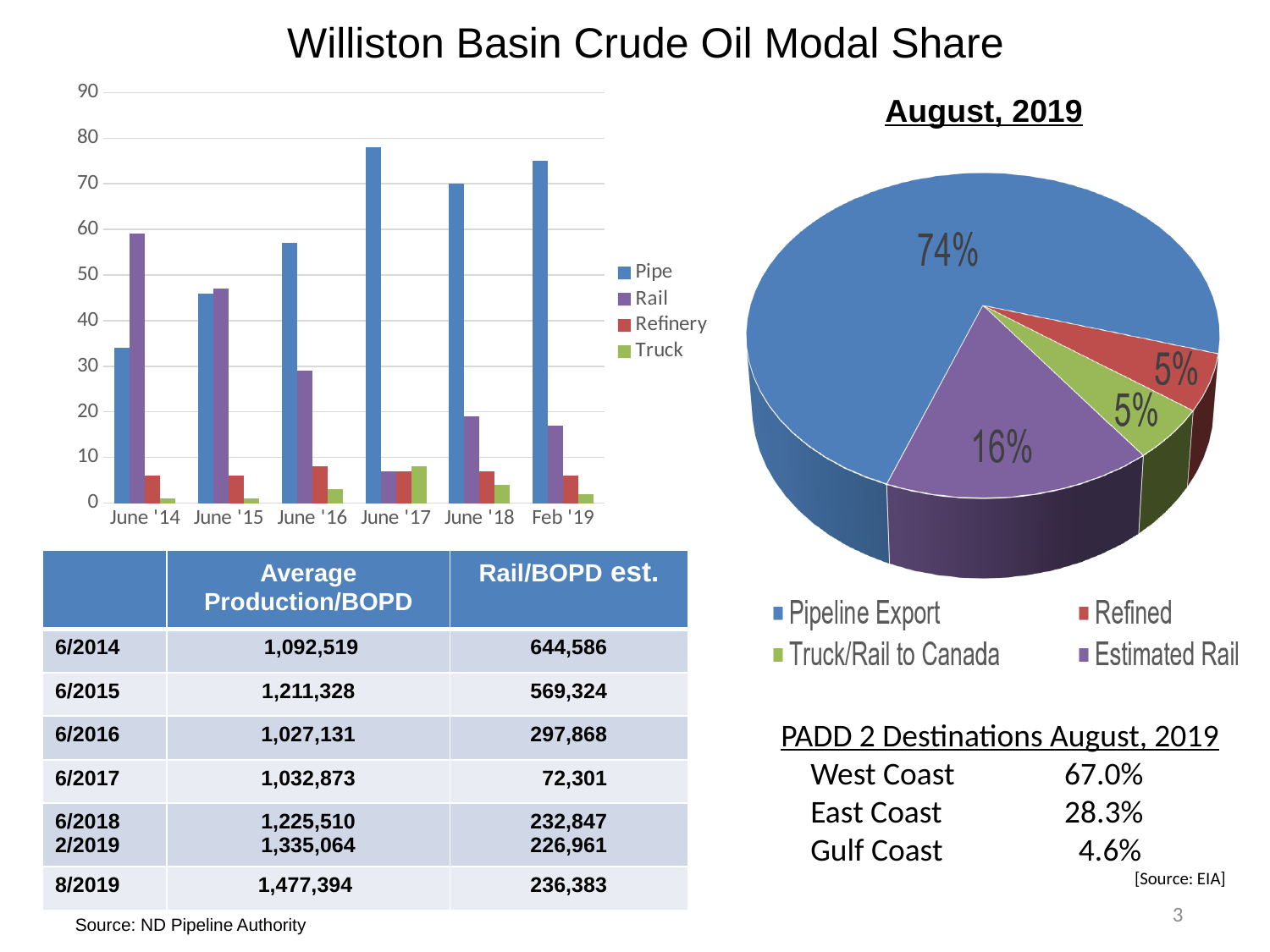
In the 'August, 2019' pie chart, what share does Pipeline Export have? 74% What kind of chart is the 'August, 2019' chart on the right side of the slide? pie chart In the bar chart on the left, is the Pipe value for June '14 greater or less than 40? less In the bar chart on the left, how many time periods are shown on the x axis? 6 In the bar chart on the left, for June '14, which is larger: Pipe or Rail? Rail In the bar chart on the left, in which period is the Rail value lowest? June '17 In the bar chart on the left, is the Pipe value for June '17 greater or less than 70? greater In the bar chart on the left, in which period is the Rail value highest? June '14 In the 'August, 2019' pie chart, what is the difference between the Pipeline Export share and the Estimated Rail share? 58 percentage points In the bar chart on the left, does the Rail value rise or fall from June '14 to June '17? fall In the bar chart on the left, how many series does the legend list? 4 What kind of chart is the chart on the left side of the slide? bar chart